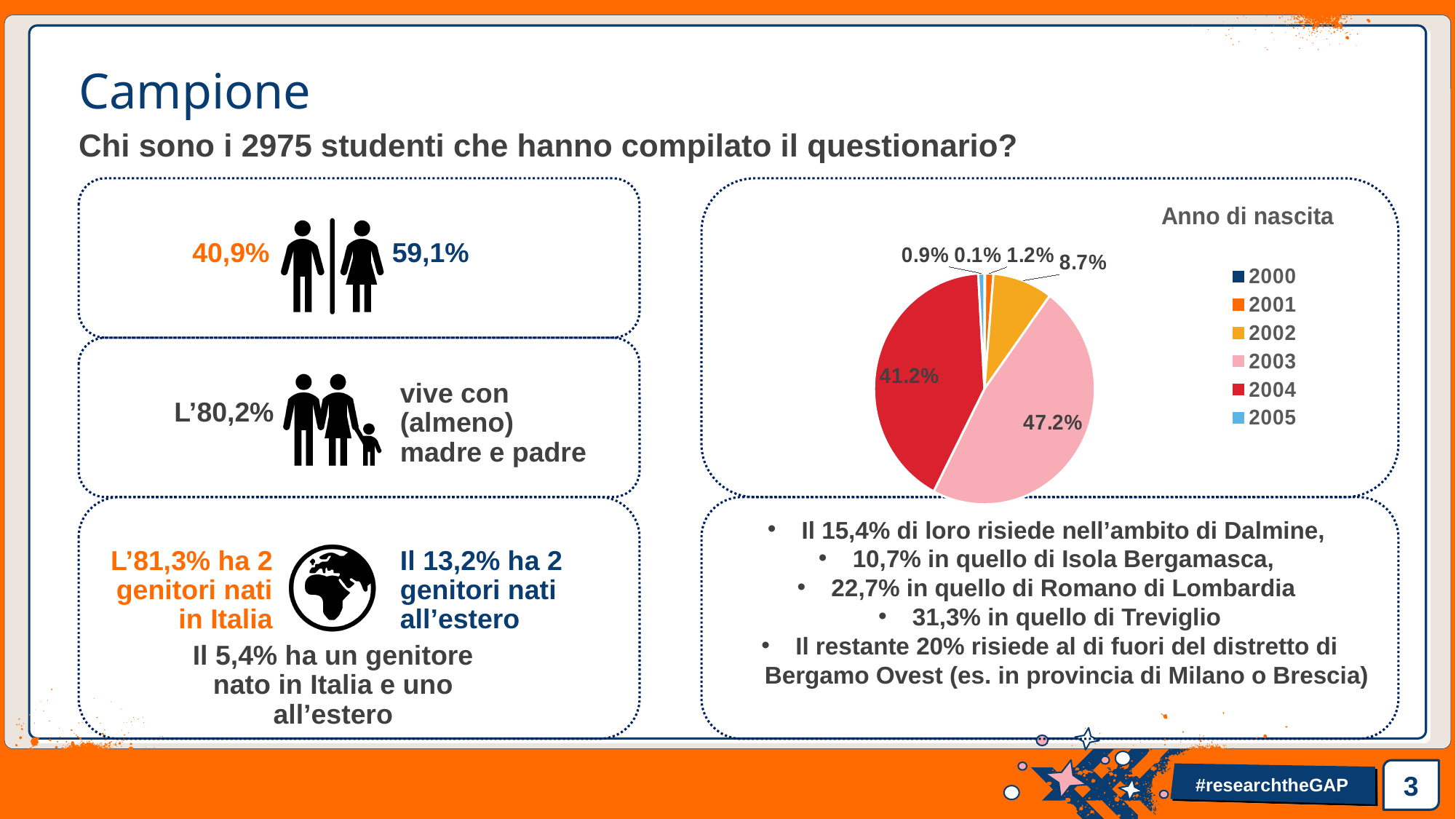
In the "Anno di nascita" pie chart, what is the combined share of students born in 2003 and 2004? 88.4% In the "Anno di nascita" pie chart, what is the difference in percentage points between the 2003 slice and the 2004 slice? 6.0 percentage points In the "Anno di nascita" pie chart, what share of students were born in 2002? 8.7% In the "Anno di nascita" pie chart, how many birth years does the legend list? 6 In the "Anno di nascita" pie chart, which slice is larger: 2002 or 2004? 2004 In the "Anno di nascita" pie chart, what is the smallest percentage labelled on any slice? 0.1% In the "Anno di nascita" pie chart, what share of students were born in 2003? 47.2% In the "Anno di nascita" pie chart, what share of students were born in 2004? 41.2% What is the title of the pie chart on the right of the slide? Anno di nascita In the "Anno di nascita" pie chart, which birth year has the largest slice? 2003 In the "Anno di nascita" pie chart, what colour represents the year 2003 in the legend? Pink What type of chart is shown under the title "Anno di nascita"? Pie chart